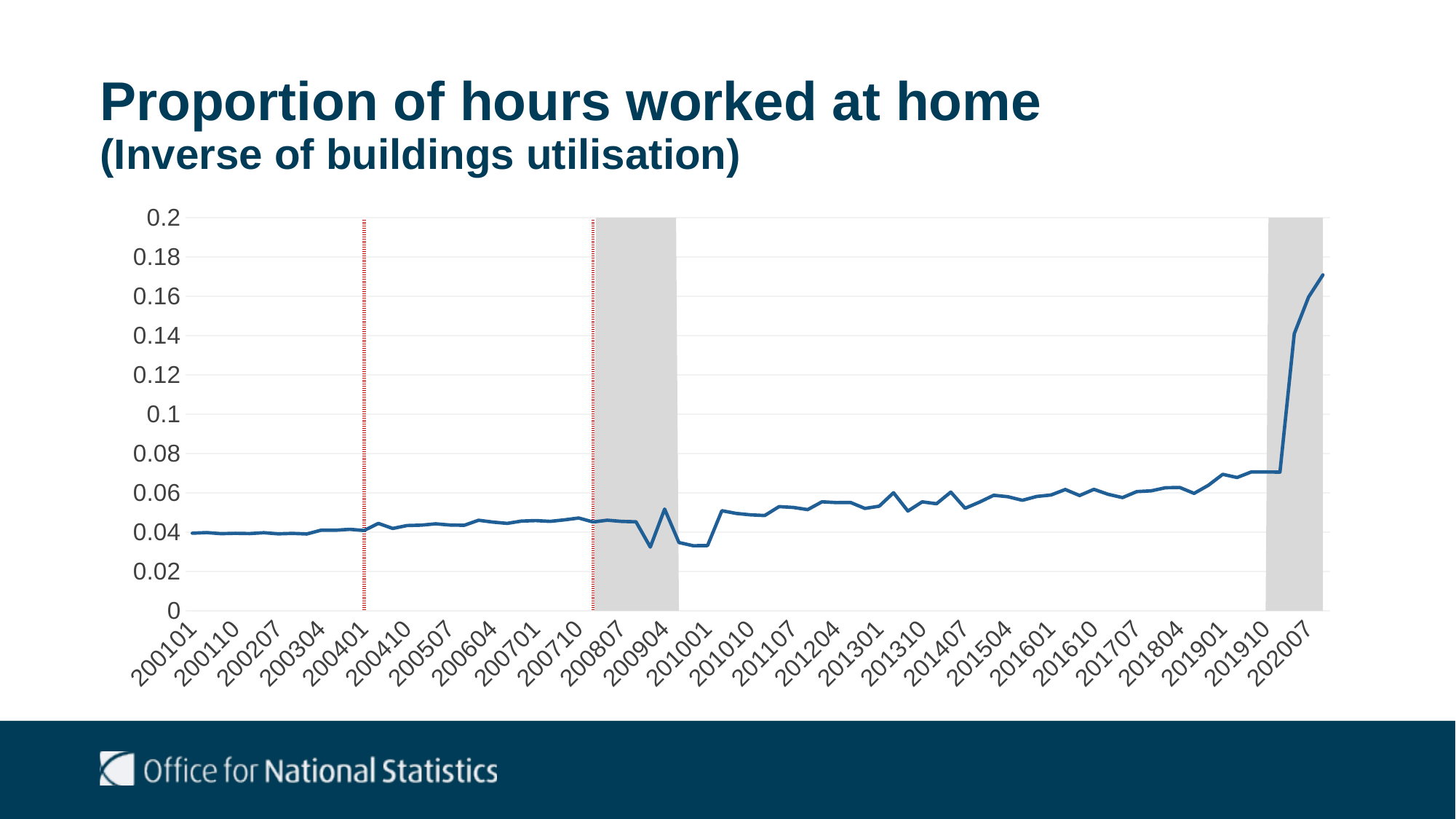
What is the title of the chart on the slide? Proportion of hours worked at home Overall, does the proportion of hours worked at home rise or fall from 200101 to the end of the series? rise Is the highest value reached by the line greater or less than 0.16? greater Is the value at 201001 greater or less than 0.06? less What kind of chart is shown on the slide? line chart Is the value at the end of the series larger or smaller than the value at 200101? larger How many lines (series) are plotted on the chart? 1 Does the line reach its highest value at the start or at the end of the period shown? end What subtitle appears beneath the chart title? (Inverse of buildings utilisation) Is the lowest value on the line greater or less than 0.02? greater